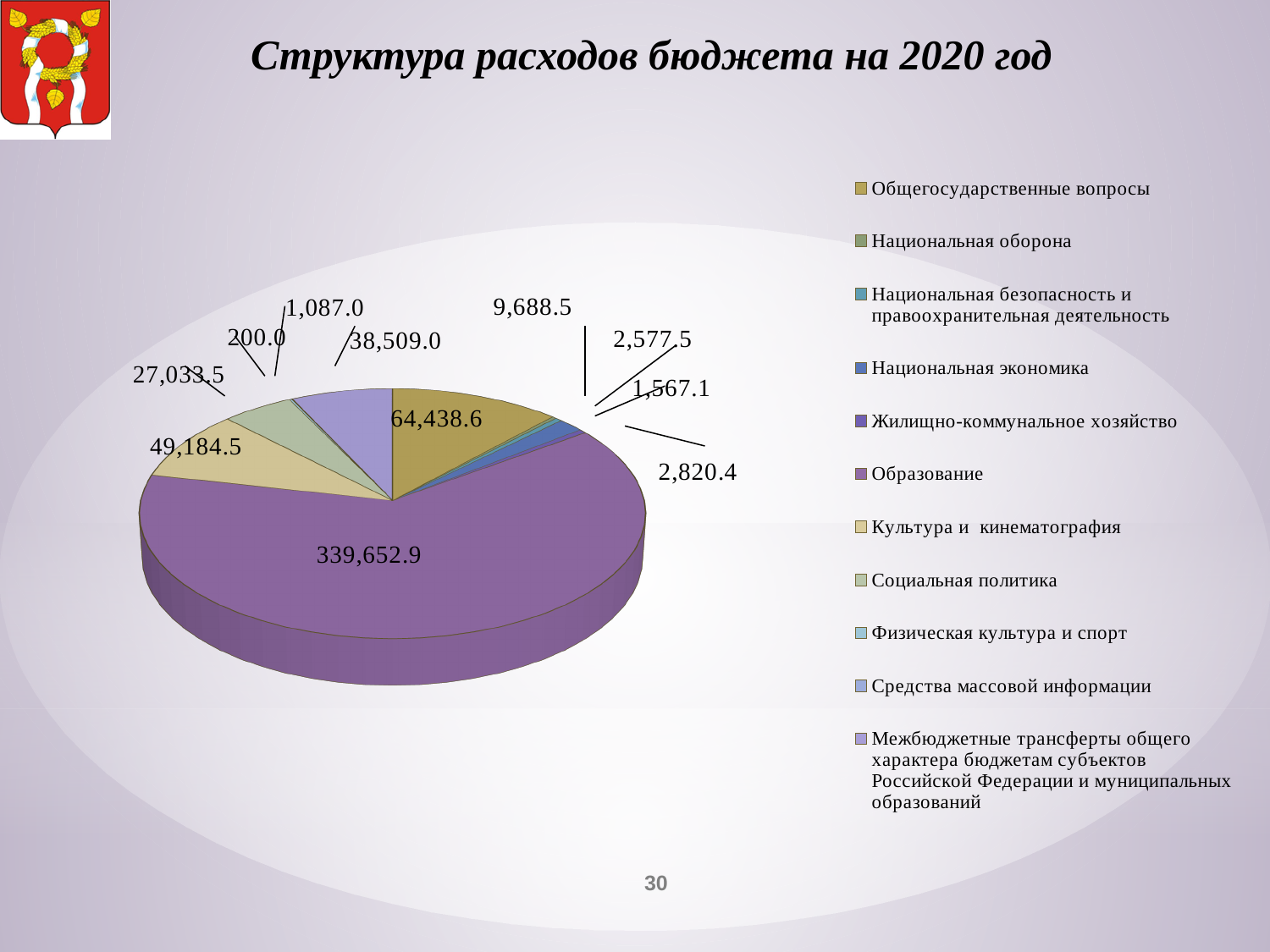
What is the title of the chart? Структура расходов бюджета на 2020 год What is the value shown for Образование? 339,652.9 Which category has the largest slice of the pie? Образование What is the smallest data label value shown on the pie chart? 200.0 What is the value shown for Межбюджетные трансферты общего характера бюджетам субъектов Российской Федерации и муниципальных образований? 38,509.0 Which is larger, the value for Образование or the value for Общегосударственные вопросы? Образование How many categories does the legend list? 11 What is the value shown for Общегосударственные вопросы? 64,438.6 What is the difference between the values for Общегосударственные вопросы and Культура и кинематография? 15,254.1 What type of chart is shown on the slide? Pie chart What is the value shown for Культура и кинематография? 49,184.5 What is the value shown for Социальная политика? 27,033.5